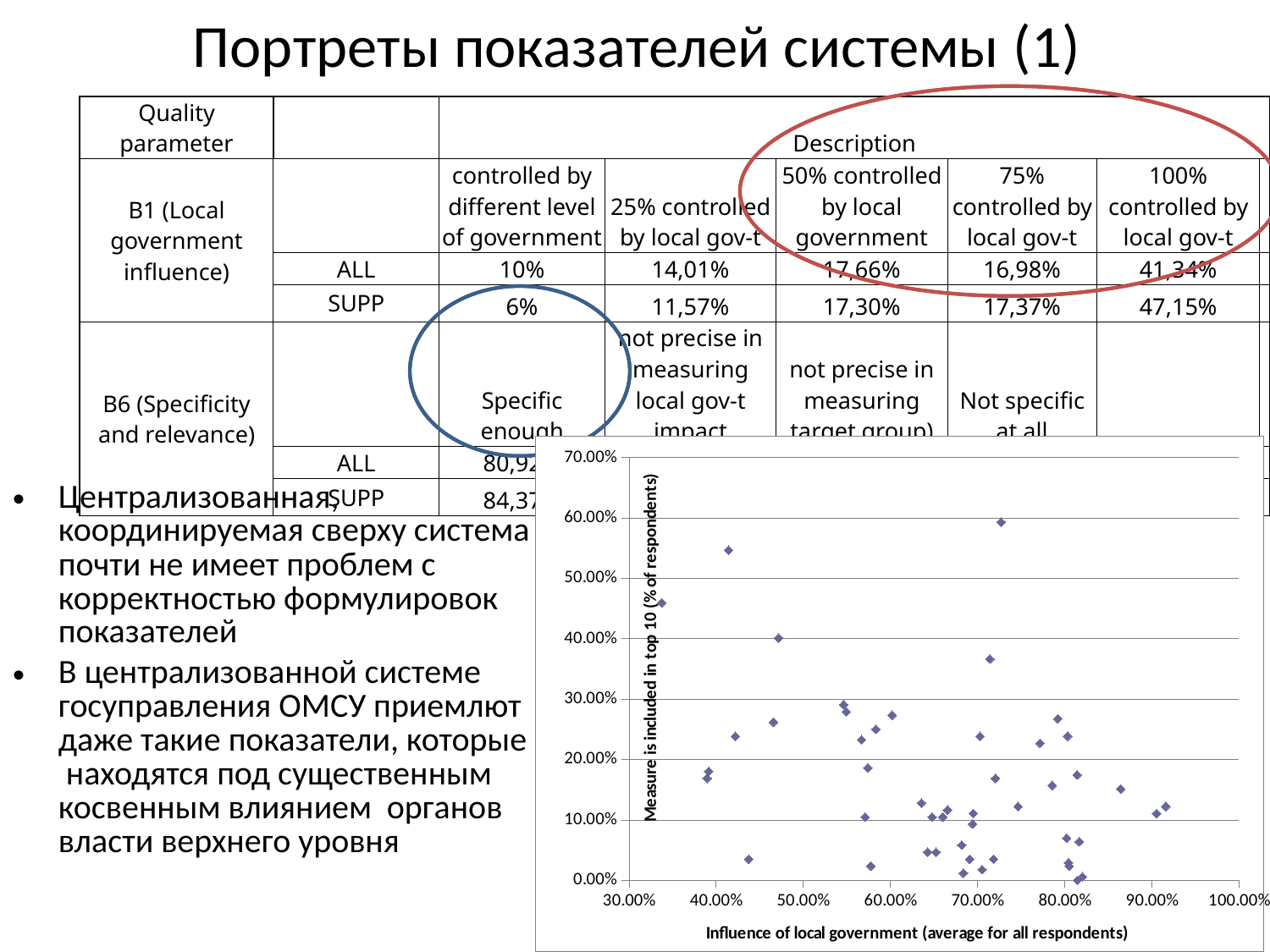
In the scatter chart, is the highest point on the vertical axis greater or less than 70.00%? less In the scatter chart, is the rightmost point on the horizontal axis greater or less than 100.00%? less In the scatter chart, is the highest point on the vertical axis greater or less than 50.00%? greater What is the title of the vertical axis of the scatter chart? Measure is included in top 10 (% of respondents) What is the title of the horizontal axis of the scatter chart? Influence of local government (average for all respondents) What kind of chart is shown on the slide? scatter chart